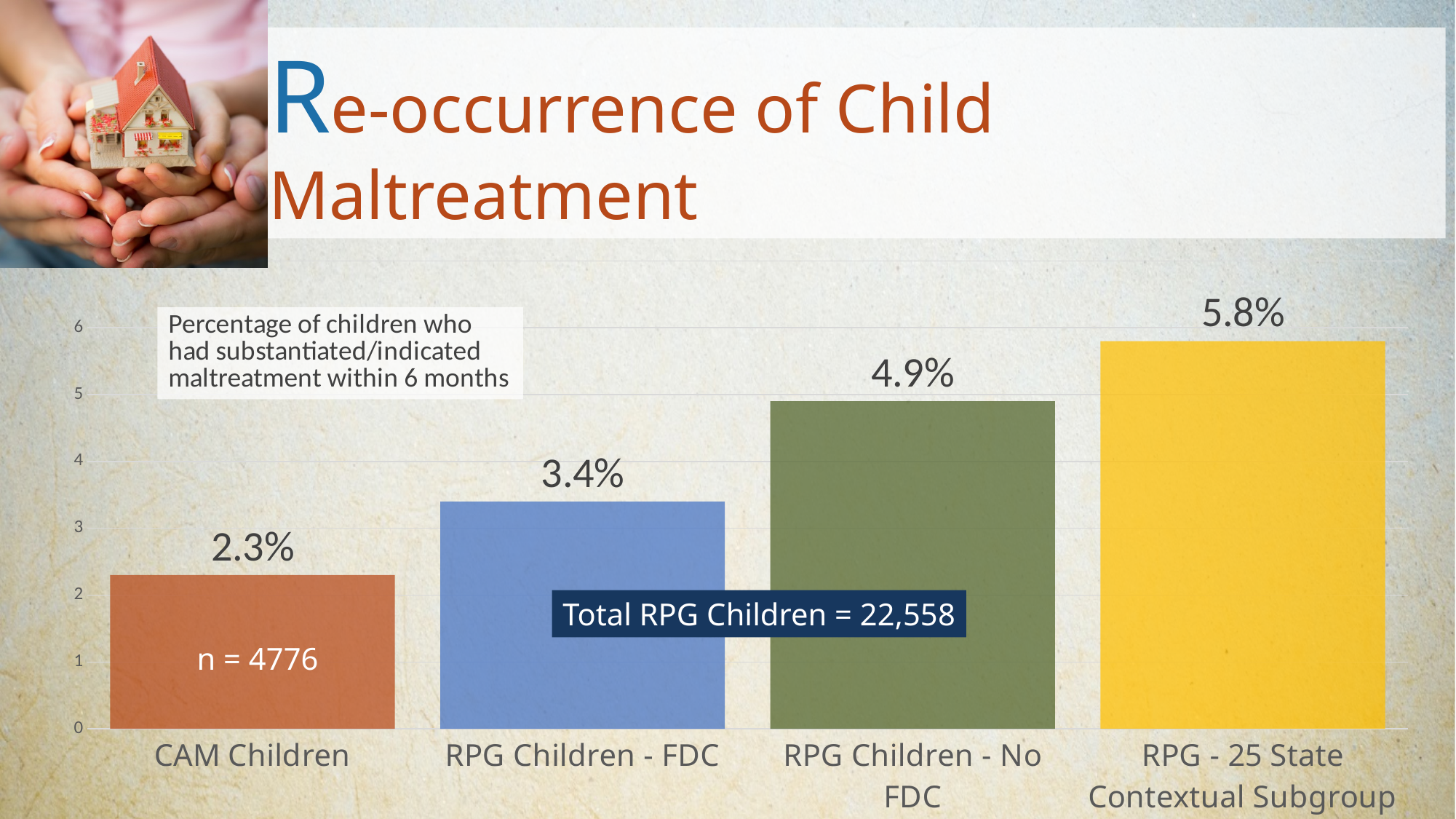
Which is larger, the value for CAM Children or the value for RPG Children - FDC? RPG Children - FDC How many categories are shown on the chart? 4 Which category has the highest value? RPG - 25 State Contextual Subgroup What is the total number of RPG children stated on the chart? 22,558 Do the values rise or fall from left to right across the categories? Rise What kind of chart is shown on the slide? Bar chart What is the value for RPG Children - No FDC? 4.9% What is the difference between the values for RPG Children - No FDC and RPG Children - FDC? 1.5% Which category has the lowest value? CAM Children What is the value for CAM Children? 2.3% What is the value for RPG - 25 State Contextual Subgroup? 5.8% What is the value for RPG Children - FDC? 3.4%